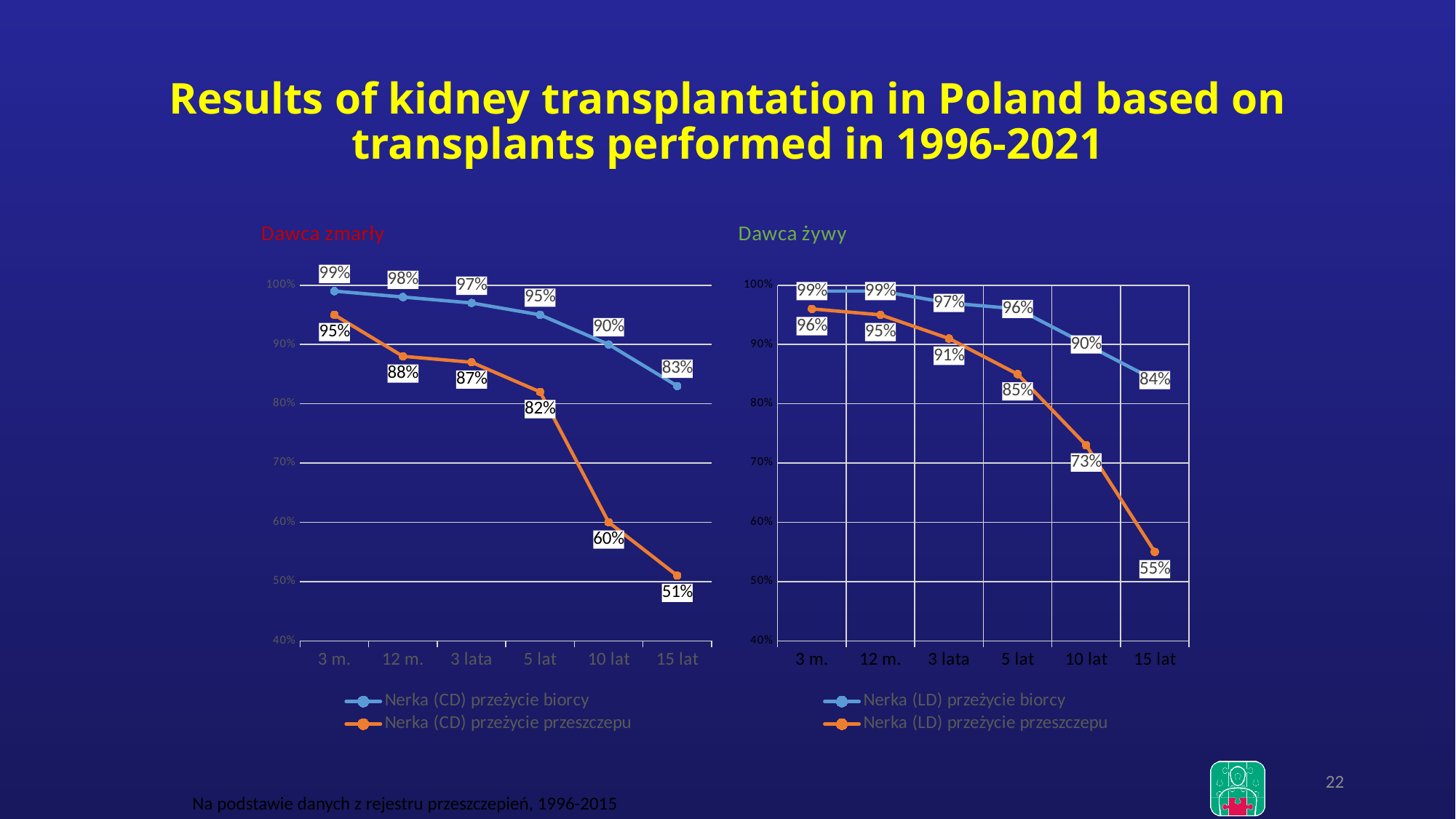
In the 'Dawca zmarły' chart, what is the value of 'Nerka (CD) przeżycie przeszczepu' at 15 lat? 51% In the 'Dawca żywy' chart, what is the difference between 'Nerka (LD) przeżycie biorcy' and 'Nerka (LD) przeżycie przeszczepu' at 15 lat? 29% In the 'Dawca zmarły' chart, what colour is the line for 'Nerka (CD) przeżycie przeszczepu'? Orange In the 'Dawca żywy' chart, what is the value of 'Nerka (LD) przeżycie przeszczepu' at 5 lat? 85% What kind of chart is the 'Dawca zmarły' chart? Line chart How many time points are shown on the x axis of the 'Dawca żywy' chart? 6 In the 'Dawca żywy' chart, do the values of 'Nerka (LD) przeżycie przeszczepu' rise or fall from 3 m. to 15 lat? Fall In the 'Dawca zmarły' chart, at which time point is 'Nerka (CD) przeżycie przeszczepu' lowest? 15 lat In the 'Dawca zmarły' chart, what is the difference between 'Nerka (CD) przeżycie biorcy' and 'Nerka (CD) przeżycie przeszczepu' at 10 lat? 30% Which is larger at 15 lat: 'Nerka (CD) przeżycie przeszczepu' in the 'Dawca zmarły' chart or 'Nerka (LD) przeżycie przeszczepu' in the 'Dawca żywy' chart? Nerka (LD) przeżycie przeszczepu How many series does the legend of the 'Dawca zmarły' chart list? 2 In the 'Dawca żywy' chart, what is the value of 'Nerka (LD) przeżycie biorcy' at 10 lat? 90%